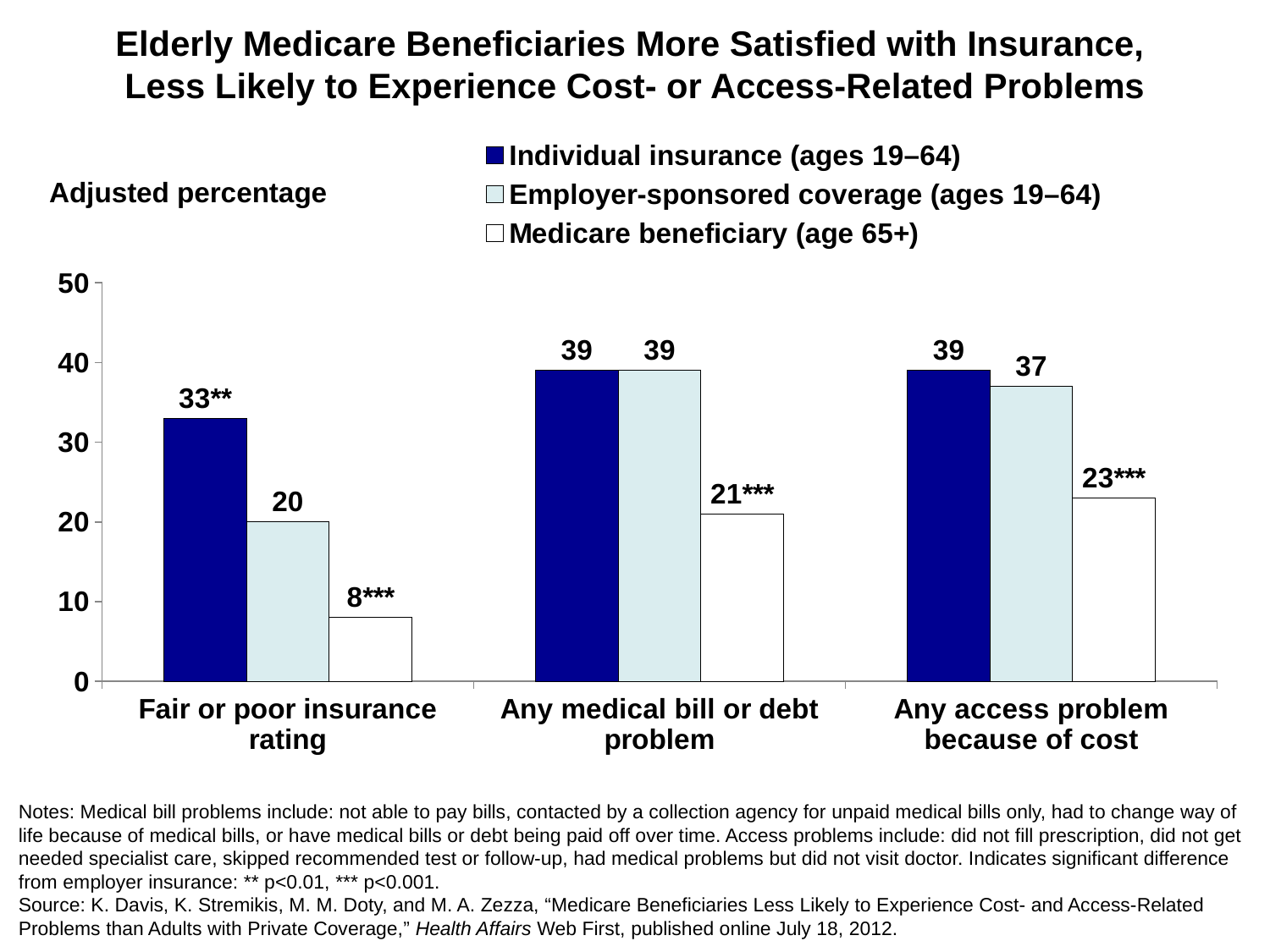
How many series does the legend list? 3 What is the value for Individual insurance (ages 19–64) in the 'Fair or poor insurance rating' category? 33 What is the difference between Individual insurance and Medicare beneficiary values in the 'Fair or poor insurance rating' category? 25 What is the difference between Employer-sponsored coverage and Medicare beneficiary values in the 'Any access problem because of cost' category? 14 What is the value for Medicare beneficiary (age 65+) in the 'Any medical bill or debt problem' category? 21 Which category has the lowest value for Medicare beneficiary (age 65+)? Fair or poor insurance rating What kind of chart is shown on the slide? Bar chart What is the value for Medicare beneficiary (age 65+) in the 'Fair or poor insurance rating' category? 8 Which is larger in the 'Any medical bill or debt problem' category: Employer-sponsored coverage or Medicare beneficiary? Employer-sponsored coverage Which category has the highest value for Employer-sponsored coverage (ages 19–64)? Any medical bill or debt problem How many categories are shown on the x axis? 3 What is the value for Employer-sponsored coverage (ages 19–64) in the 'Any access problem because of cost' category? 37